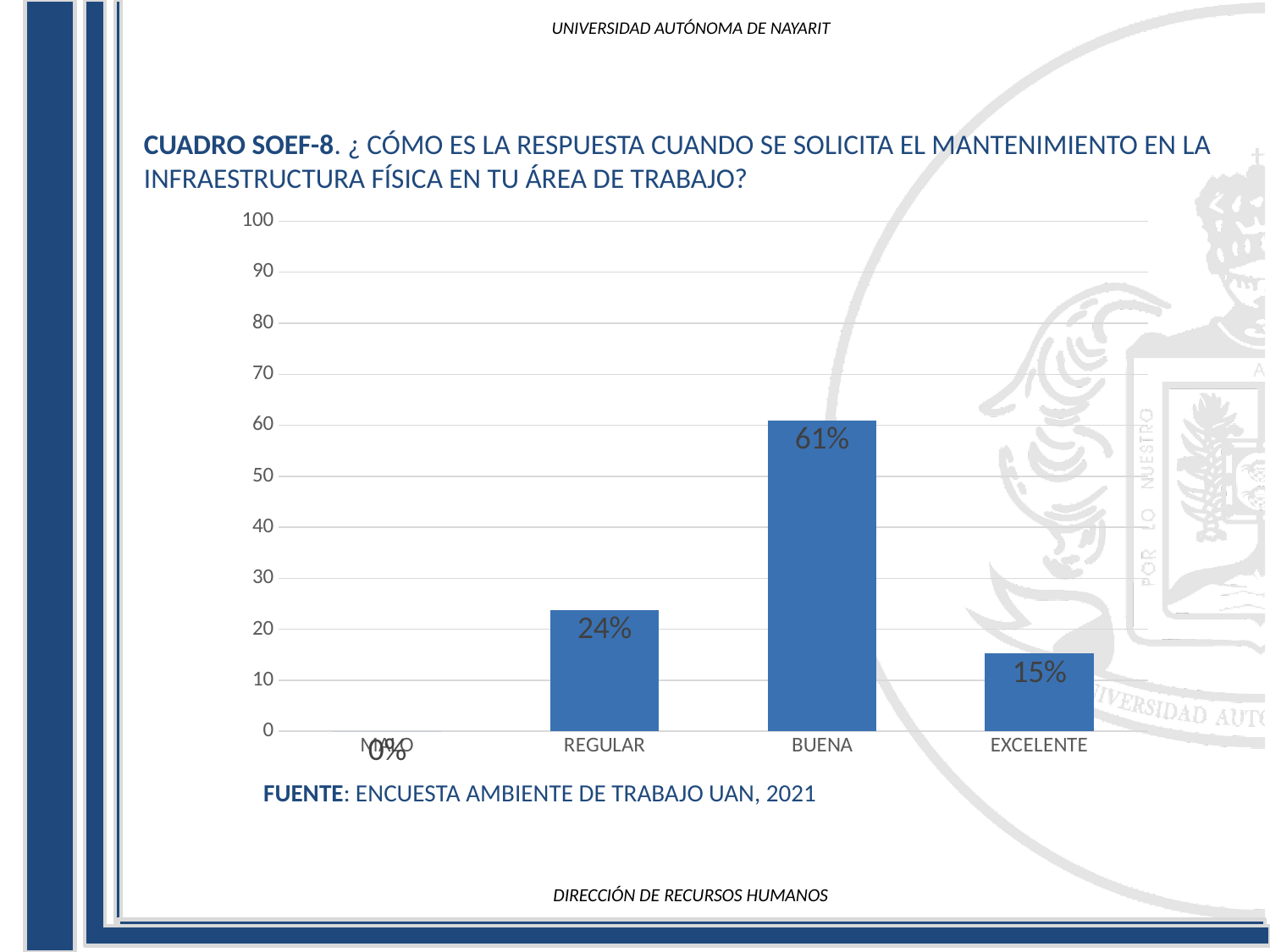
Which is larger, the value for REGULAR or the value for EXCELENTE? REGULAR What is the value for REGULAR? 24% What is the difference between the values for REGULAR and EXCELENTE? 9% Is the value for EXCELENTE greater or less than 20? less Is the value for BUENA greater or less than 50? greater What is the value for EXCELENTE? 15% How many categories are shown on the x axis? 4 What is the value for BUENA? 61% Which category has the highest value? BUENA What kind of chart is shown on the slide? bar chart What is the difference between the values for BUENA and REGULAR? 37% What source is cited below the chart? ENCUESTA AMBIENTE DE TRABAJO UAN, 2021